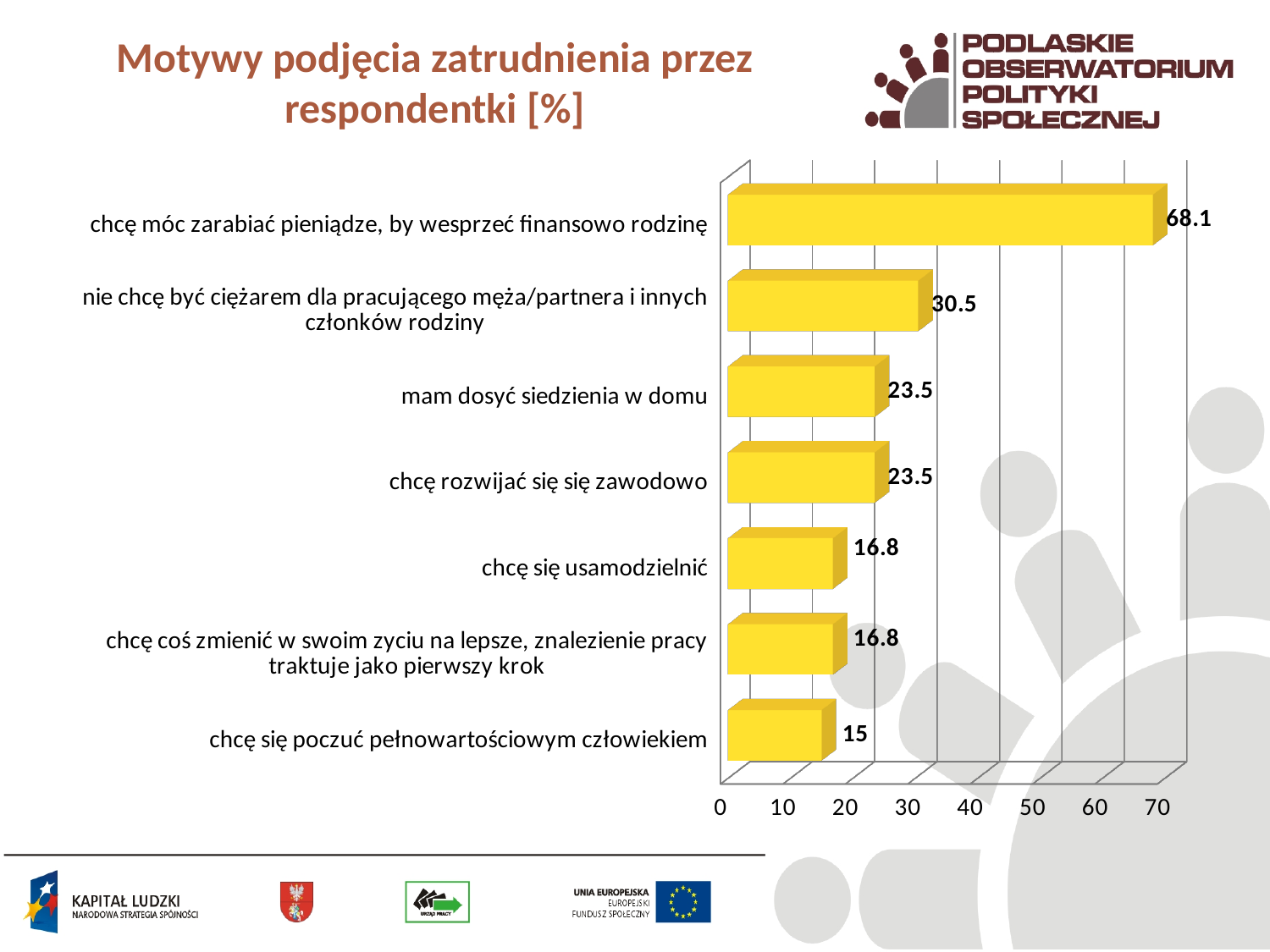
Is the value for "nie chcę być ciężarem dla pracującego męża/partnera i innych członków rodziny" greater or less than 40? less What is the difference between the values for "chcę móc zarabiać pieniądze, by wesprzeć finansowo rodzinę" and "nie chcę być ciężarem dla pracującego męża/partnera i innych członków rodziny"? 37.6 How many categories are shown in the chart? 7 What kind of chart is shown on the slide? bar chart What is the title of the chart? Motywy podjęcia zatrudnienia przez respondentki [%] What is the value for "chcę się usamodzielnić"? 16.8 What is the value for "chcę móc zarabiać pieniądze, by wesprzeć finansowo rodzinę"? 68.1 What is the value for "nie chcę być ciężarem dla pracującego męża/partnera i innych członków rodziny"? 30.5 Which category has the highest value? chcę móc zarabiać pieniądze, by wesprzeć finansowo rodzinę Which category has the lowest value? chcę się poczuć pełnowartościowym człowiekiem What is the value for "chcę się poczuć pełnowartościowym człowiekiem"? 15 Which is larger: the value for "mam dosyć siedzenia w domu" or the value for "chcę się usamodzielnić"? mam dosyć siedzenia w domu